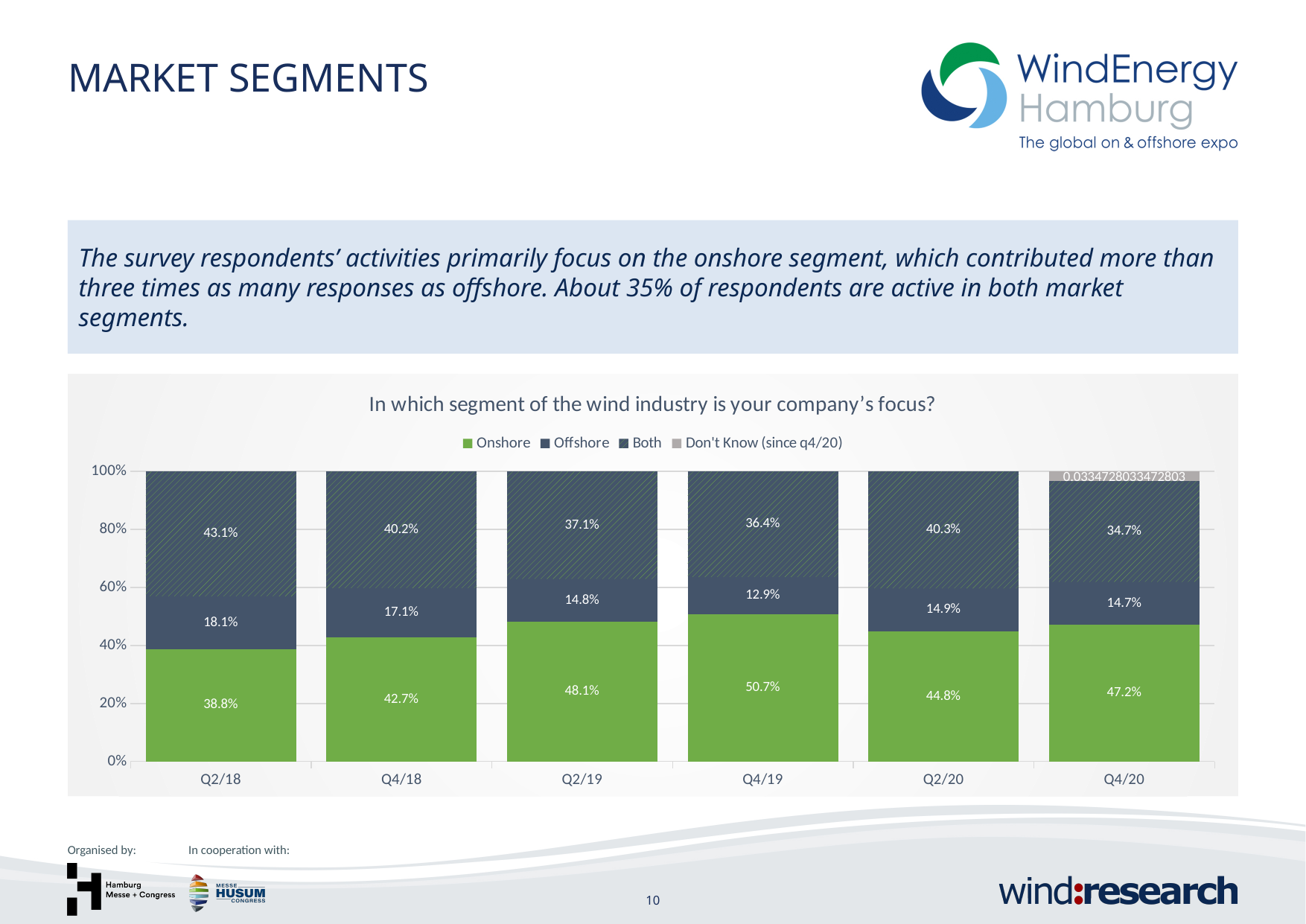
What is the difference between the Onshore share in Q4/19 and in Q2/18? 11.9 percentage points Does the Offshore share rise or fall from Q2/18 to Q4/19? Fall How many series does the legend list? 4 In which quarter is the Both share highest? Q2/18 In which quarter is the Offshore share lowest? Q4/19 What is the Onshore share for Q2/18? 38.8% What is the Offshore share for Q4/19? 12.9% How many quarters are shown on the x axis? 6 What is the value for Both in Q2/20? 40.3% What kind of chart is shown? Stacked bar chart Which is larger in Q4/18: the Onshore share or the Both share? Onshore In which quarter is the Onshore share highest? Q4/19